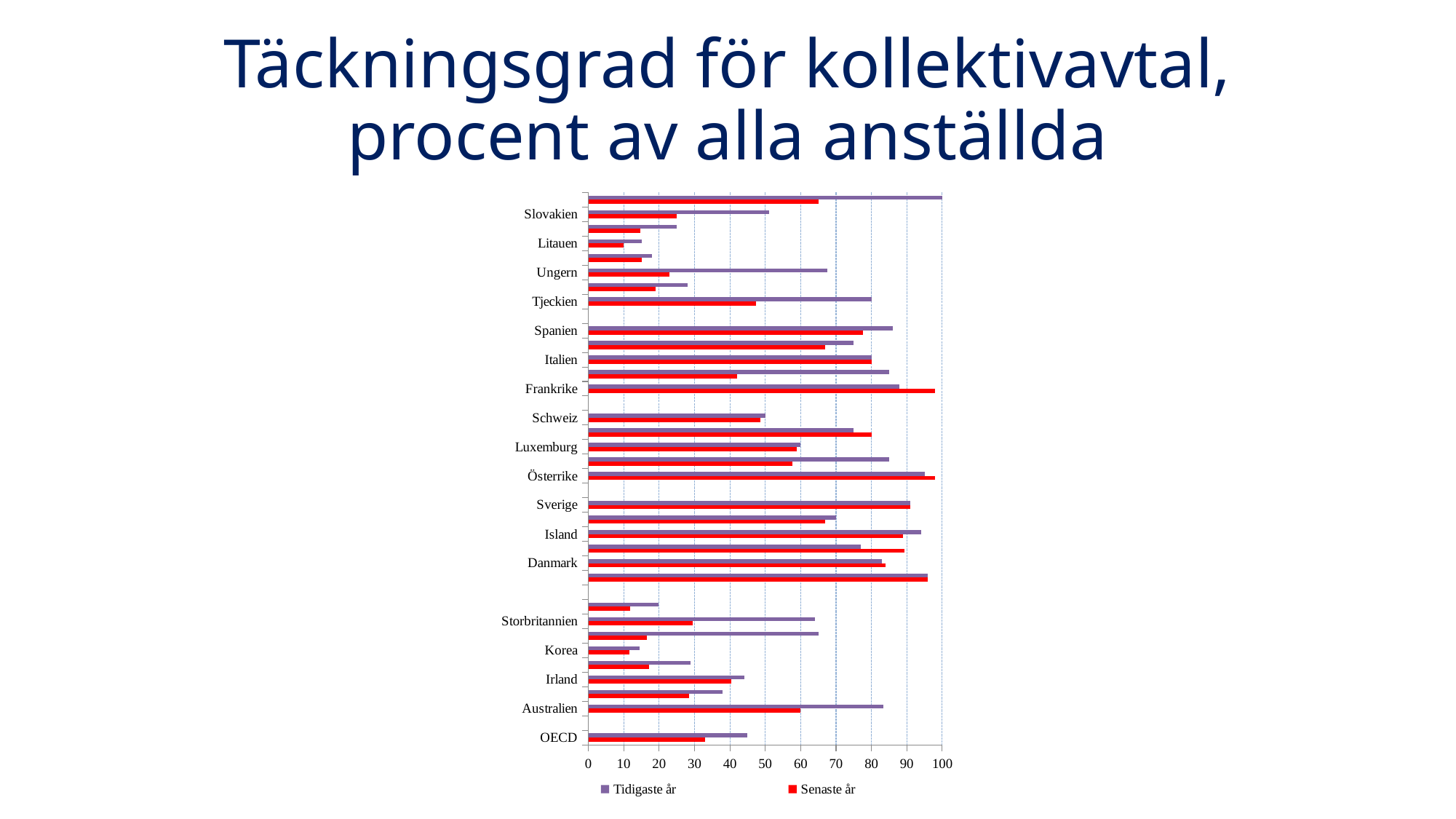
What are the two series named in the legend? Tidigaste år and Senaste år Is the Senaste år value for Frankrike greater or less than 90? greater For Storbritannien, which series has the larger value, Tidigaste år or Senaste år? Tidigaste år Which series is drawn in red? Senaste år What kind of chart is shown on the slide? Bar chart Is the Senaste år value for Storbritannien greater or less than 40? less How many series does the legend list? 2 Is the Senaste år value for Australien greater or less than 50? greater Which has the larger Senaste år value, Australien or OECD? Australien